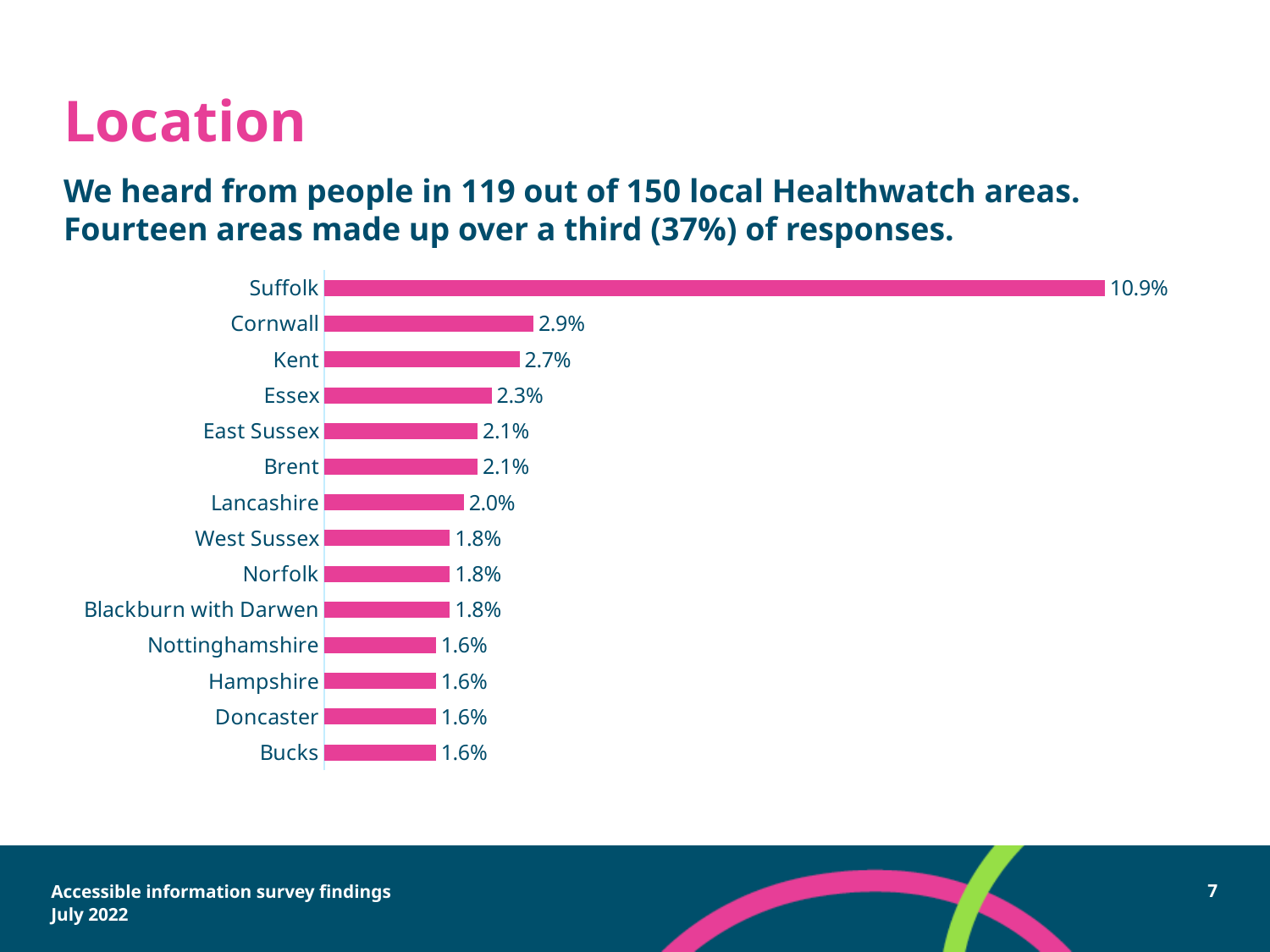
What is the difference between the values for Essex and Bucks? 0.7% What is the value for Suffolk? 10.9% What is the value for Blackburn with Darwen? 1.8% What is the difference between the values for Suffolk and Cornwall? 8.0% What colour are the bars in the chart? Pink Which area has the highest value? Suffolk How many areas are shown in the chart? 14 Which is larger, the value for Cornwall or the value for Essex? Cornwall Which is larger, the value for Kent or the value for Norfolk? Kent What is the value for Lancashire? 2.0% What kind of chart is shown on the slide? Bar chart What is the value for Kent? 2.7%